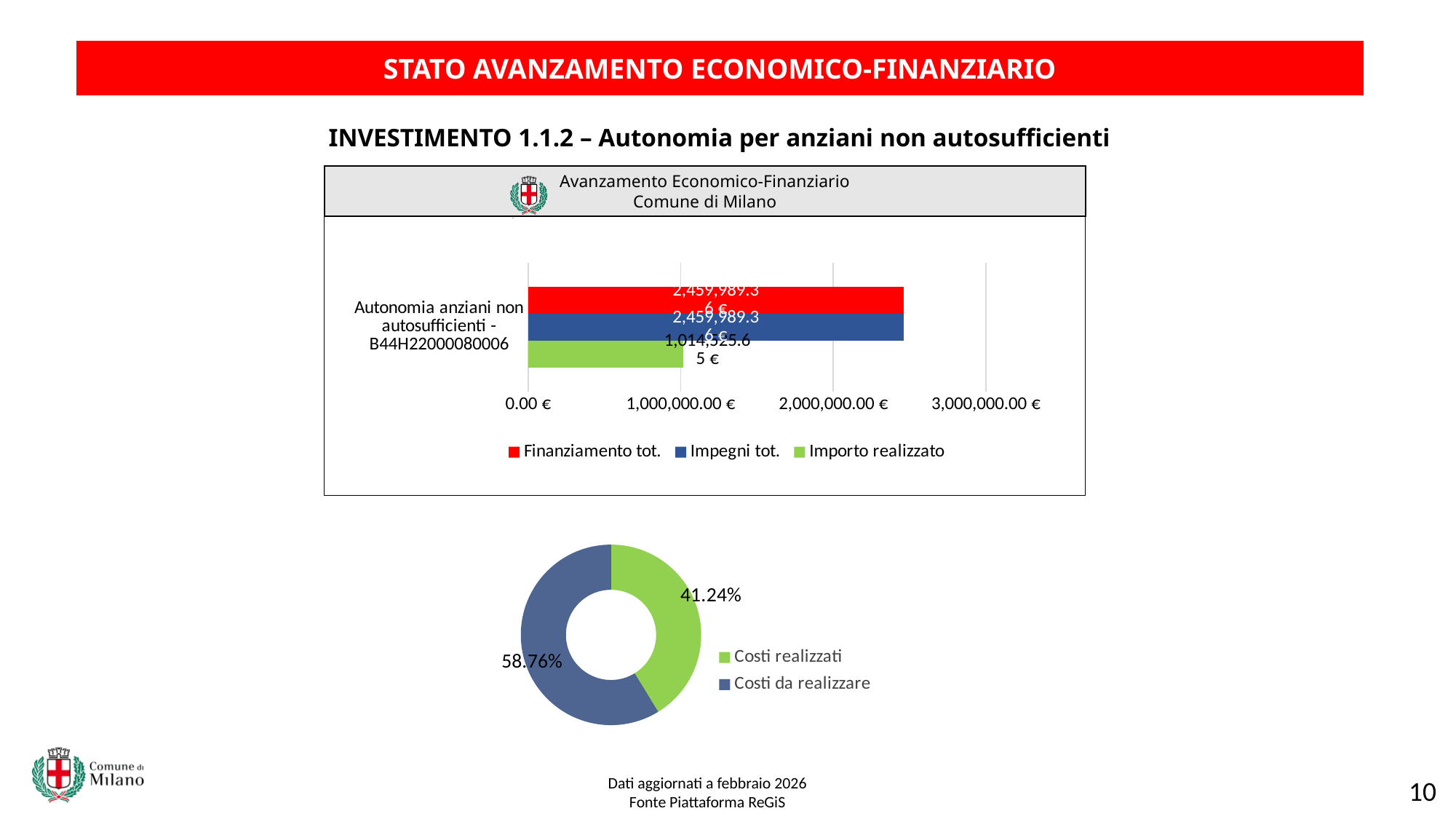
What kind of chart is the upper chart titled "Avanzamento Economico-Finanziario Comune di Milano"? bar chart What kind of chart is the lower chart showing Costi realizzati and Costi da realizzare? donut chart In the upper bar chart, how many series does the legend list? 3 In the upper bar chart, is the value for Finanziamento tot. greater or less than 2,000,000.00 €? greater In the upper bar chart, which series has the lowest value? Importo realizzato In the upper bar chart, is the value for Impegni tot. greater or less than 3,000,000.00 €? less In the upper bar chart, is the value for Importo realizzato greater or less than 2,000,000.00 €? less In the upper bar chart, which is larger: Finanziamento tot. or Importo realizzato? Finanziamento tot. In the lower donut chart, what share is Costi realizzati? 41.24% In the lower donut chart, which slice is larger: Costi realizzati or Costi da realizzare? Costi da realizzare In the upper bar chart, how many categories are shown on the vertical axis? 1 In the lower donut chart, what share is Costi da realizzare? 58.76%